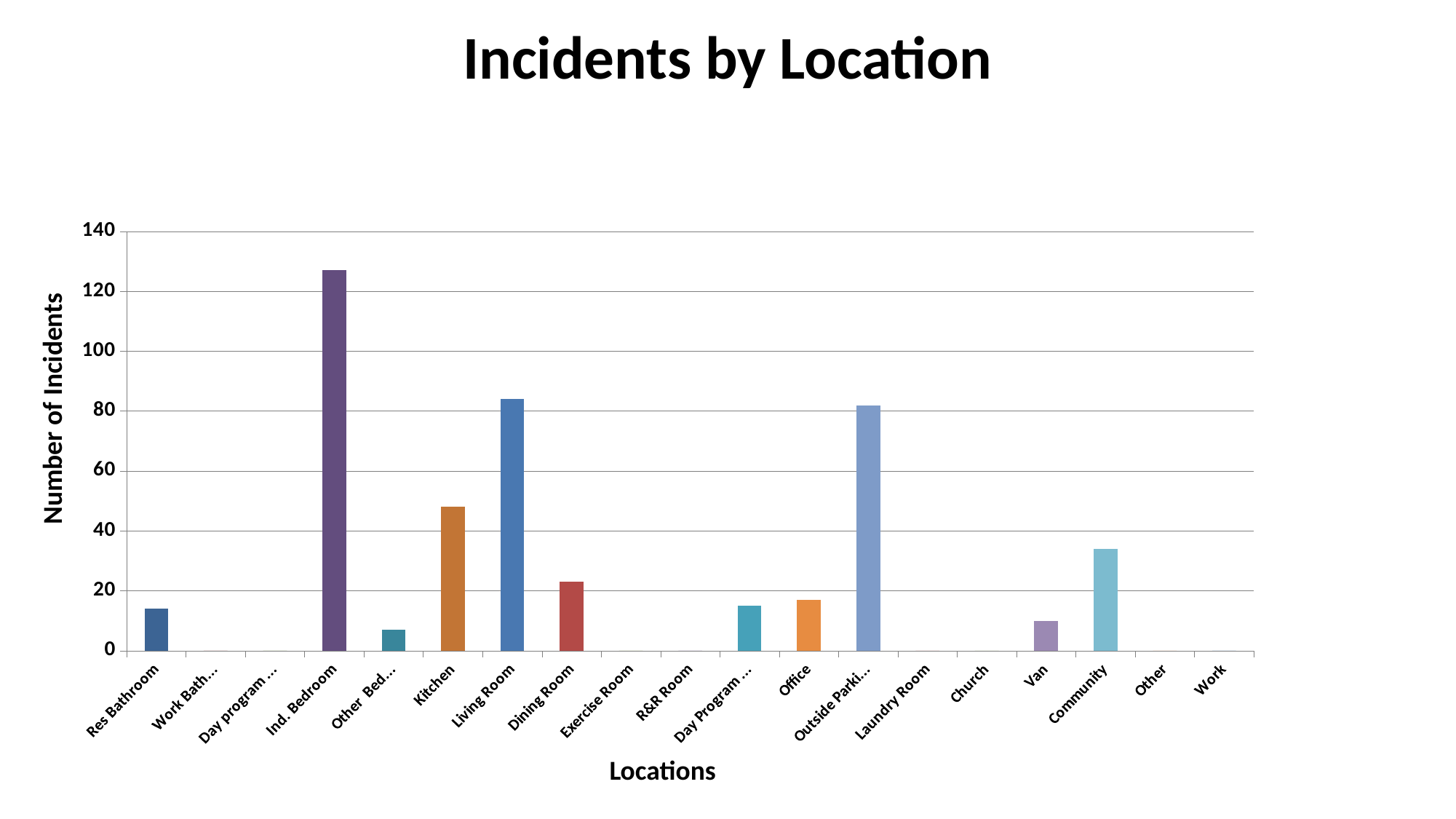
Is the value for Res Bathroom greater or less than 20? less Is the value for Kitchen greater or less than 60? less Which has more incidents, Kitchen or Community? Kitchen What type of chart is shown on the slide? bar chart Which location has the highest number of incidents? Ind. Bedroom Is the value for Living Room greater or less than 100? less What is the title of the chart? Incidents by Location Which has more incidents, Van or Community? Community How many location categories are shown on the x axis? 19 What is the label on the vertical axis of the chart? Number of Incidents